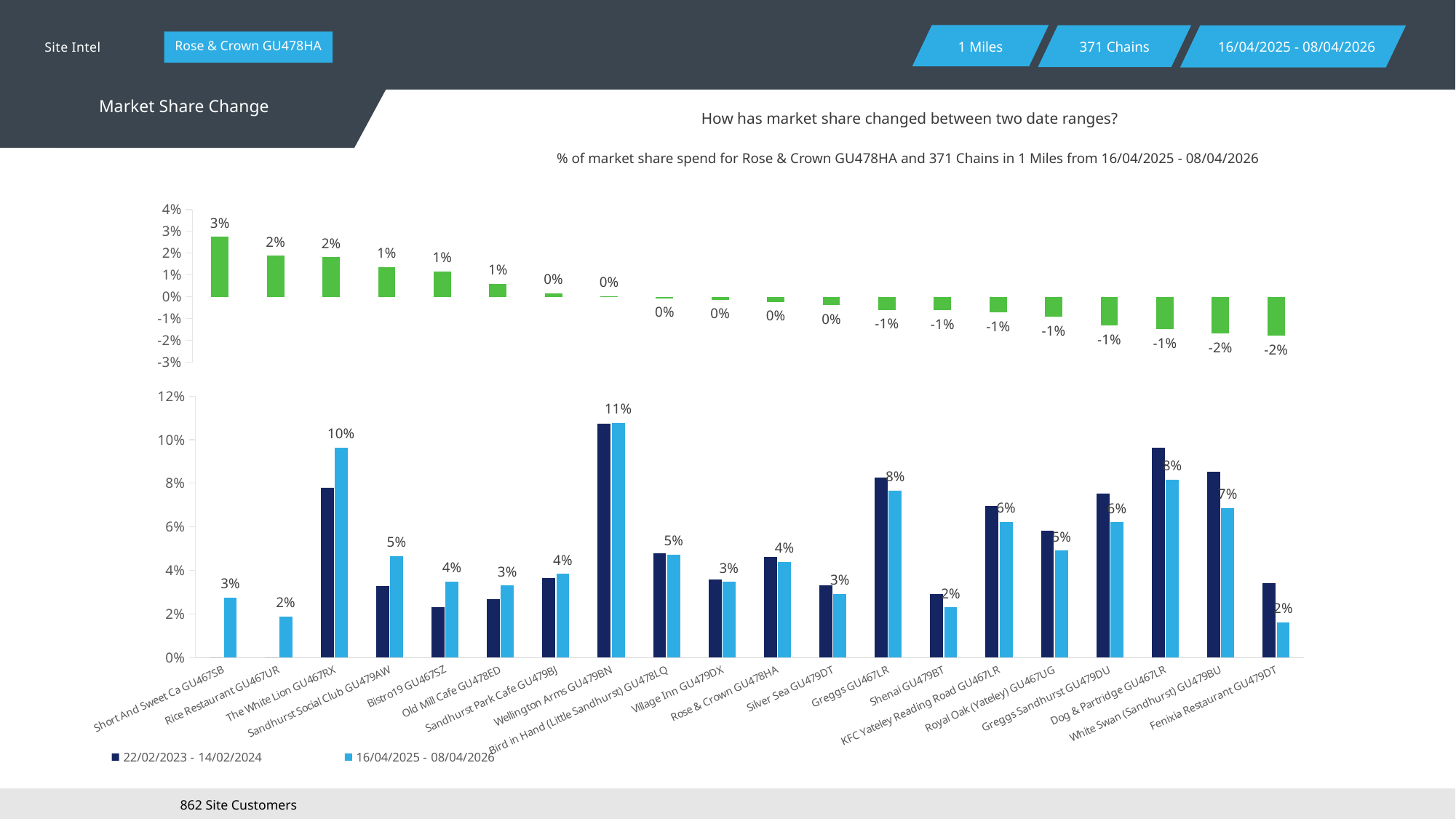
In the lower chart, is the 22/02/2023 - 14/02/2024 value for Wellington Arms GU479BN greater or less than 10%? greater How many locations are shown along the x axis of the lower chart? 20 In the upper (market share change) chart, do the values rise or fall from left to right? fall How many series does the legend of the lower chart list? 2 In the lower chart, what is the difference between the 16/04/2025 - 08/04/2026 values for The White Lion GU467RX and Rice Restaurant GU467UR? 8 percentage points In the lower chart, what is the market share for Wellington Arms GU479BN in the 16/04/2025 - 08/04/2026 period? 11% What kind of chart is the lower chart on the slide? bar chart In the upper (market share change) chart, which location has the highest change? Short And Sweet Ca GU467SB In the lower chart, which has the larger 16/04/2025 - 08/04/2026 value: Greggs GU467LR or KFC Yateley Reading Road GU467LR? Greggs GU467LR In the upper (market share change) chart, what is the change shown for The White Lion GU467RX? 2% In the lower chart, which location has the highest market share for the 16/04/2025 - 08/04/2026 period? Wellington Arms GU479BN What are the two date ranges listed in the legend of the lower chart? 22/02/2023 - 14/02/2024 and 16/04/2025 - 08/04/2026